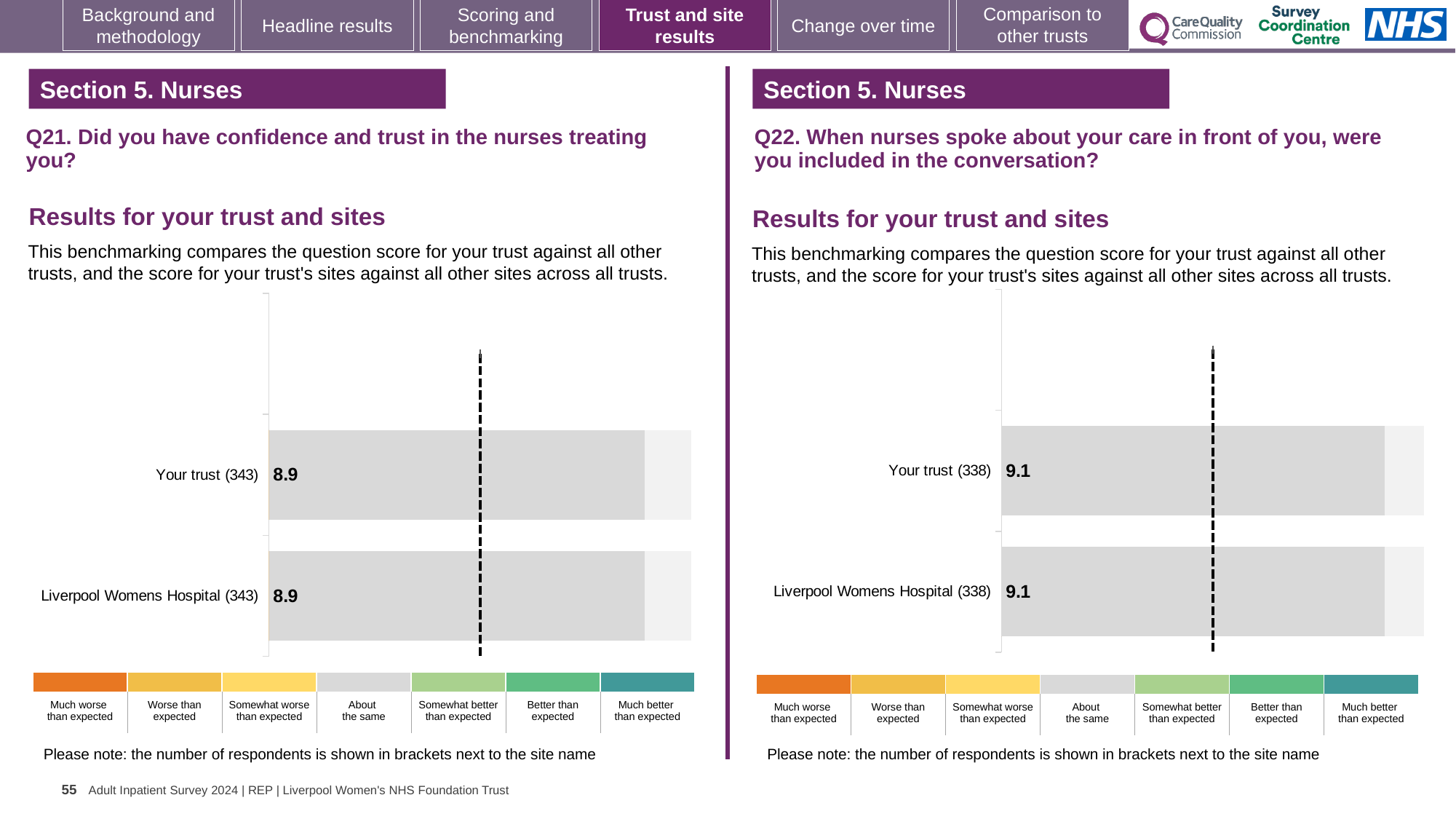
How many bars are plotted on the Q22 chart (right)? 2 On the Q22 chart (right), how many respondents are shown in brackets next to Liverpool Womens Hospital? 338 On the Q21 chart (left), what is the score for Your trust? 8.9 What kind of chart is used on the Q21 chart (left)? Bar chart On the Q21 chart (left), how many respondents are shown in brackets next to Your trust? 343 How many bars are plotted on the Q21 chart (left)? 2 On the Q22 chart (right), what is the difference between the Your trust score and the Liverpool Womens Hospital score? 0 On the Q21 chart (left), what is the difference between the Your trust score and the Liverpool Womens Hospital score? 0 On the Q22 chart (right), what is the score for Your trust? 9.1 On the Q21 chart (left), what is the score for Liverpool Womens Hospital? 8.9 On the Q22 chart (right), what is the score for Liverpool Womens Hospital? 9.1 Is the Your trust score on the Q22 chart (right) larger or smaller than the Your trust score on the Q21 chart (left)? Larger